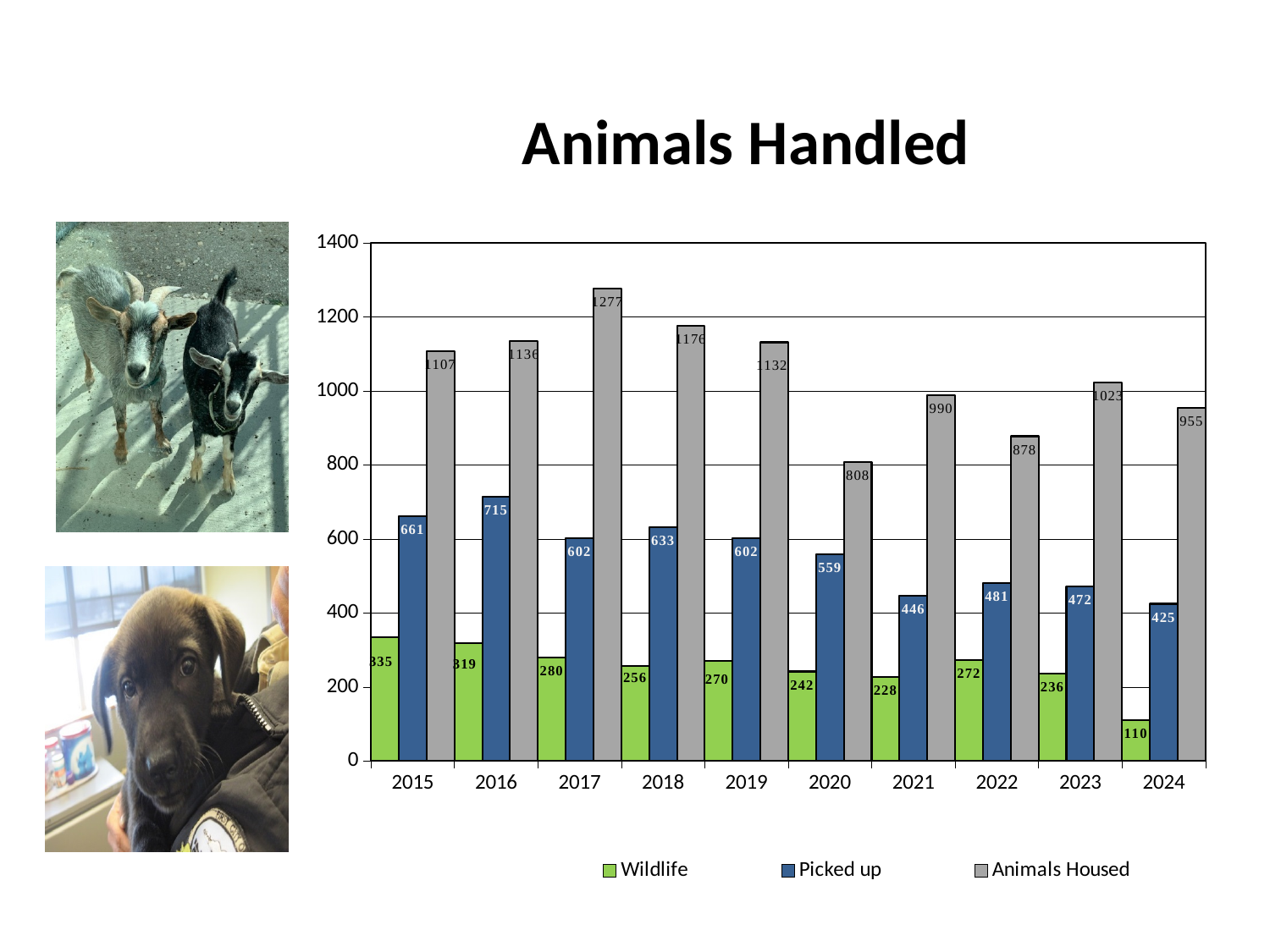
In which year is the Wildlife value lowest? 2024 What kind of chart is shown on the slide? bar chart In which year is the Animals Housed value highest? 2017 What is the difference between the Picked up values for 2016 and 2024? 290 What is the Wildlife value for 2022? 272 How many years are shown on the x axis? 10 Which year has the larger Animals Housed value, 2021 or 2022? 2021 Do the Wildlife values generally rise or fall from 2015 to 2024? fall What is the title of the chart? Animals Handled How many series does the legend list? 3 What is the Animals Housed value for 2017? 1277 What is the Picked up value for 2020? 559